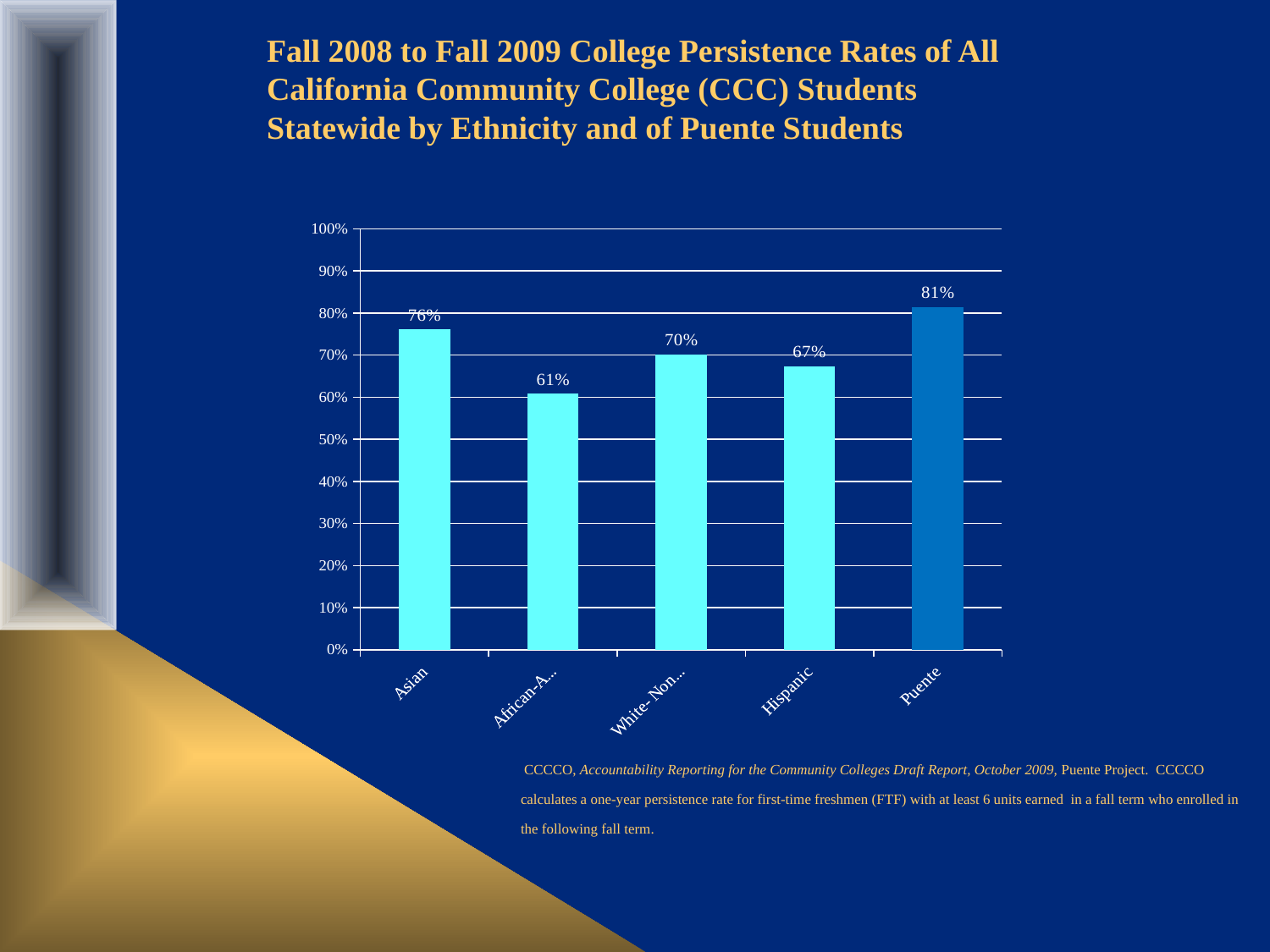
Which is larger, the rate for Asian students or the rate for Hispanic students? Asian What value is shown for the third bar from the left (labelled "White-Non...")? 70% Which bar is shown in a different (darker blue) colour from the others? Puente What is the persistence rate for Asian students? 76% Which category has the highest persistence rate? Puente What is the persistence rate for Hispanic students? 67% What type of chart is shown on the slide? Bar chart Which category has the lowest persistence rate? African-A... What value is shown for the second bar from the left (labelled "African-A...")? 61% How many bars are shown in the chart? 5 What is the persistence rate for Puente students? 81% What is the difference between the Puente rate and the Hispanic rate? 14%